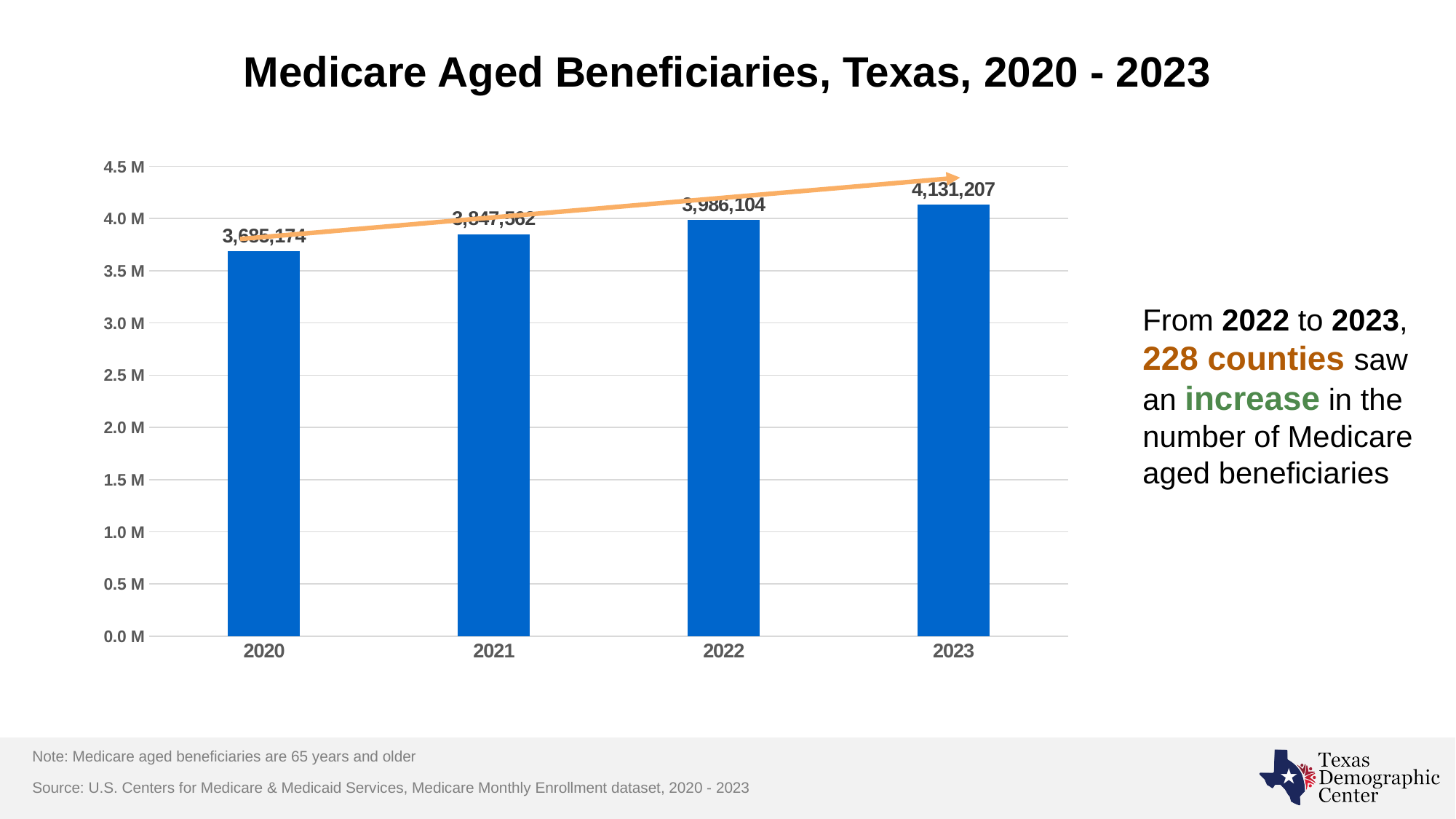
Which year has the lowest number of Medicare aged beneficiaries? 2020 Which year has the highest number of Medicare aged beneficiaries? 2023 Do the values rise or fall from 2020 to 2023? Rise What is the difference in Medicare aged beneficiaries between 2023 and 2022? 145,103 What kind of chart is shown on the slide? Bar chart How many years are shown on the chart? 4 What is the number of Medicare aged beneficiaries in Texas in 2023? 4,131,207 Which year has more Medicare aged beneficiaries, 2021 or 2022? 2022 What is the number of Medicare aged beneficiaries in Texas in 2022? 3,986,104 What is the title of the chart? Medicare Aged Beneficiaries, Texas, 2020 - 2023 Is the value for 2021 greater or less than 4.0 M? less Is the value for 2020 greater or less than 3.5 M? greater